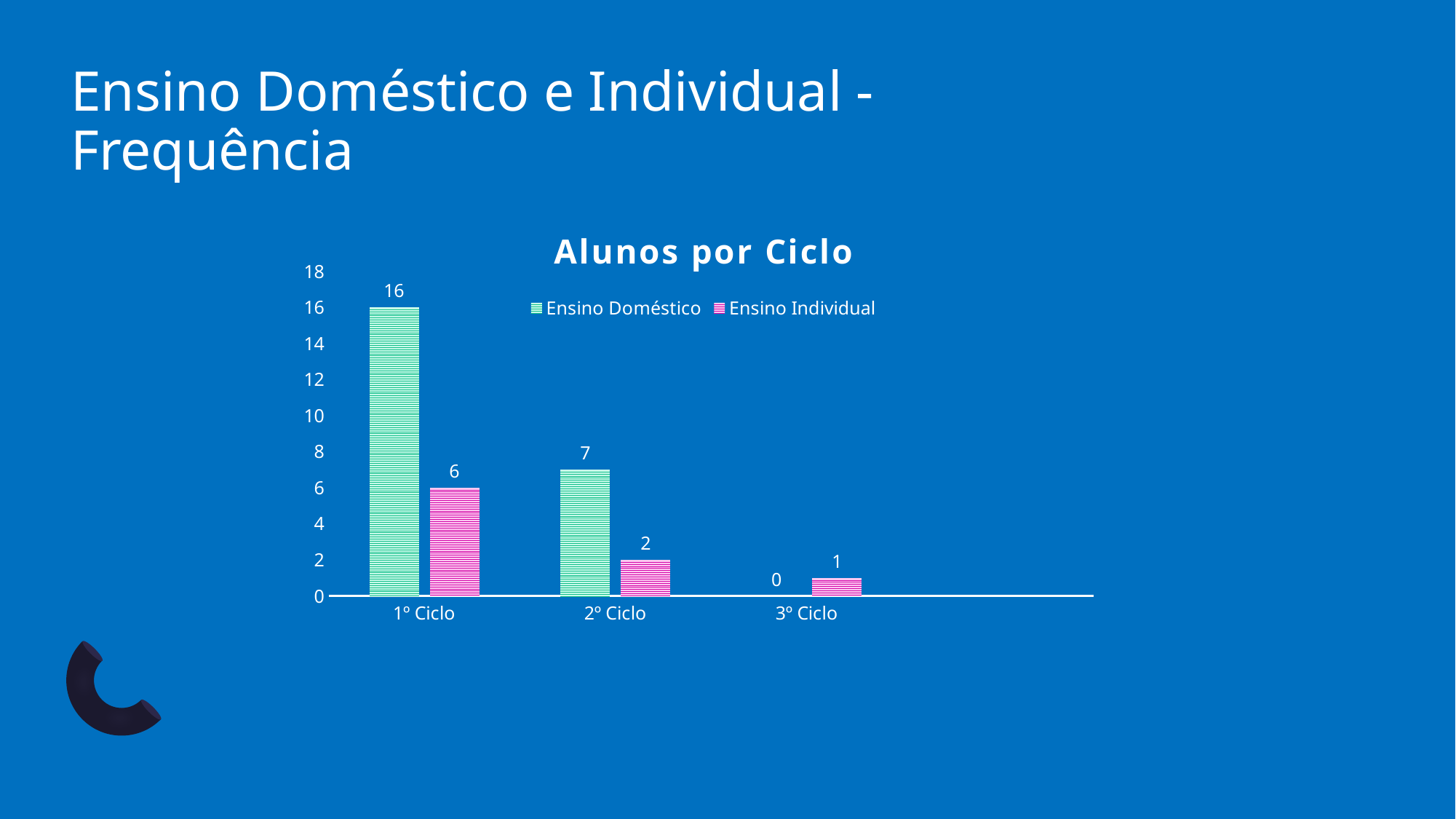
Which category has the lowest value for Ensino Doméstico? 3º Ciclo How many categories are shown on the x axis? 3 How many series does the legend list? 2 Do the Ensino Doméstico values rise or fall from 1º Ciclo to 3º Ciclo? fall What is the title of the chart? Alunos por Ciclo Which category has the highest value for Ensino Individual? 1º Ciclo What is the value for Ensino Individual in 2º Ciclo? 2 What kind of chart is shown? bar chart What is the difference between Ensino Doméstico and Ensino Individual in 1º Ciclo? 10 What is the value for Ensino Doméstico in 1º Ciclo? 16 What is the value for Ensino Doméstico in 3º Ciclo? 0 Which is larger in 2º Ciclo, Ensino Doméstico or Ensino Individual? Ensino Doméstico